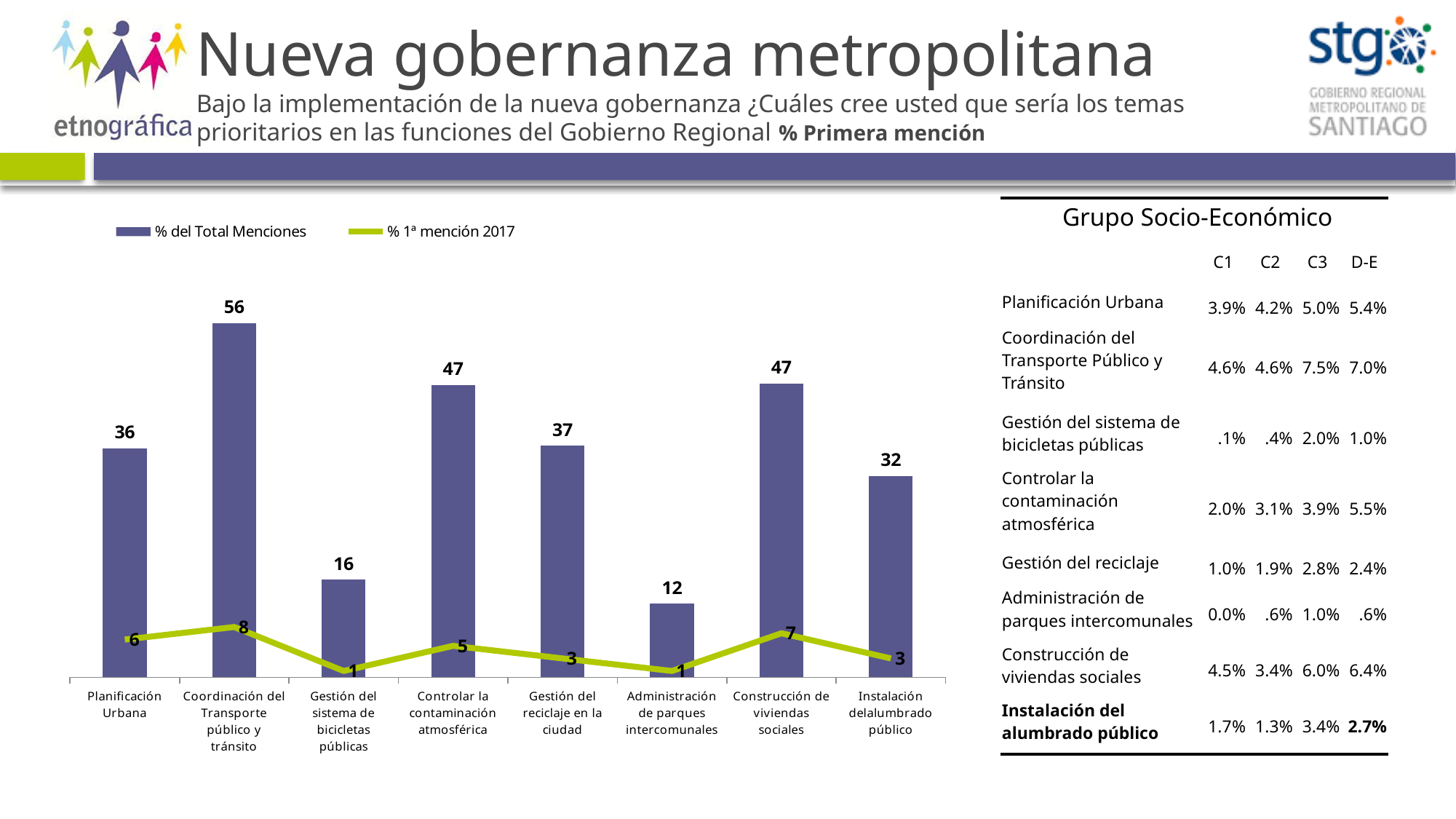
Which is larger for "% del Total Menciones": Gestión del reciclaje en la ciudad or Gestión del sistema de bicicletas públicas? Gestión del reciclaje en la ciudad What is the value of "% del Total Menciones" for Instalación del alumbrado público? 32 How many categories are shown on the x axis of the chart? 8 What is the difference between the "% 1ª mención 2017" values for Coordinación del Transporte público y tránsito and Gestión del sistema de bicicletas públicas? 7 Which category has the lowest value for "% del Total Menciones"? Administración de parques intercomunales What is the difference between the "% del Total Menciones" values for Coordinación del Transporte público y tránsito and Planificación Urbana? 20 Which series is drawn as a green line in the chart? % 1ª mención 2017 What is the value of "% del Total Menciones" for Coordinación del Transporte público y tránsito? 56 Which category has the highest value for "% del Total Menciones"? Coordinación del Transporte público y tránsito What kind of chart is shown on the slide? Combined bar and line chart What is the value of "% 1ª mención 2017" for Construcción de viviendas sociales? 7 How many series does the chart legend list? 2